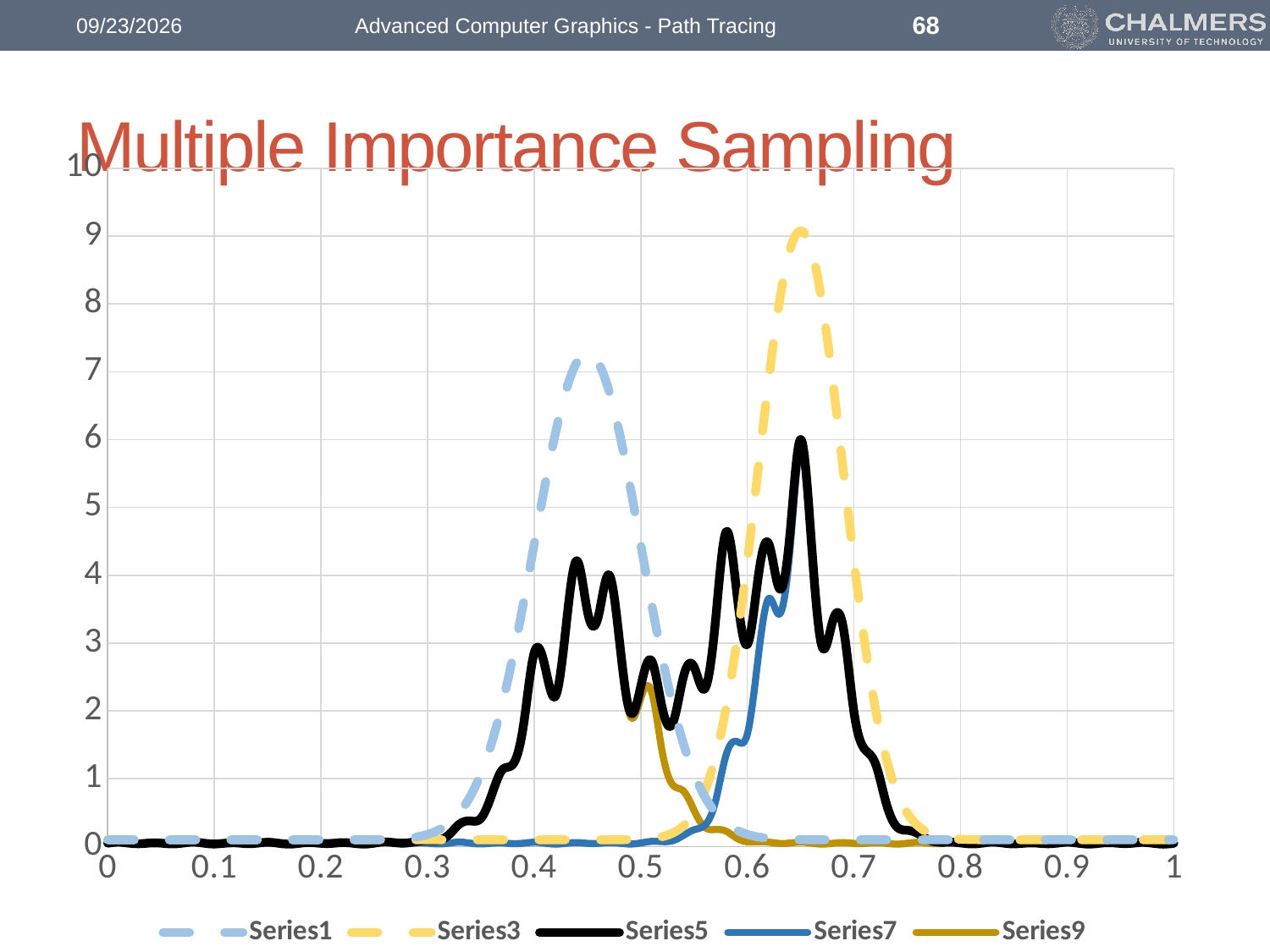
Which two series are drawn with dashed lines? Series1 and Series3 Is the peak value of Series1 greater or less than 6? greater Which series has the lowest peak value on the chart? Series9 Is the peak value of Series3 greater or less than 8? greater Which series reaches a higher peak, Series1 or Series5? Series1 How many series does the legend list? 5 Which series reaches the highest peak value on the chart? Series3 What kind of chart is shown on the slide? line chart Is the peak value of Series5 greater or less than 7? less What is the title of the slide containing the chart? Multiple Importance Sampling